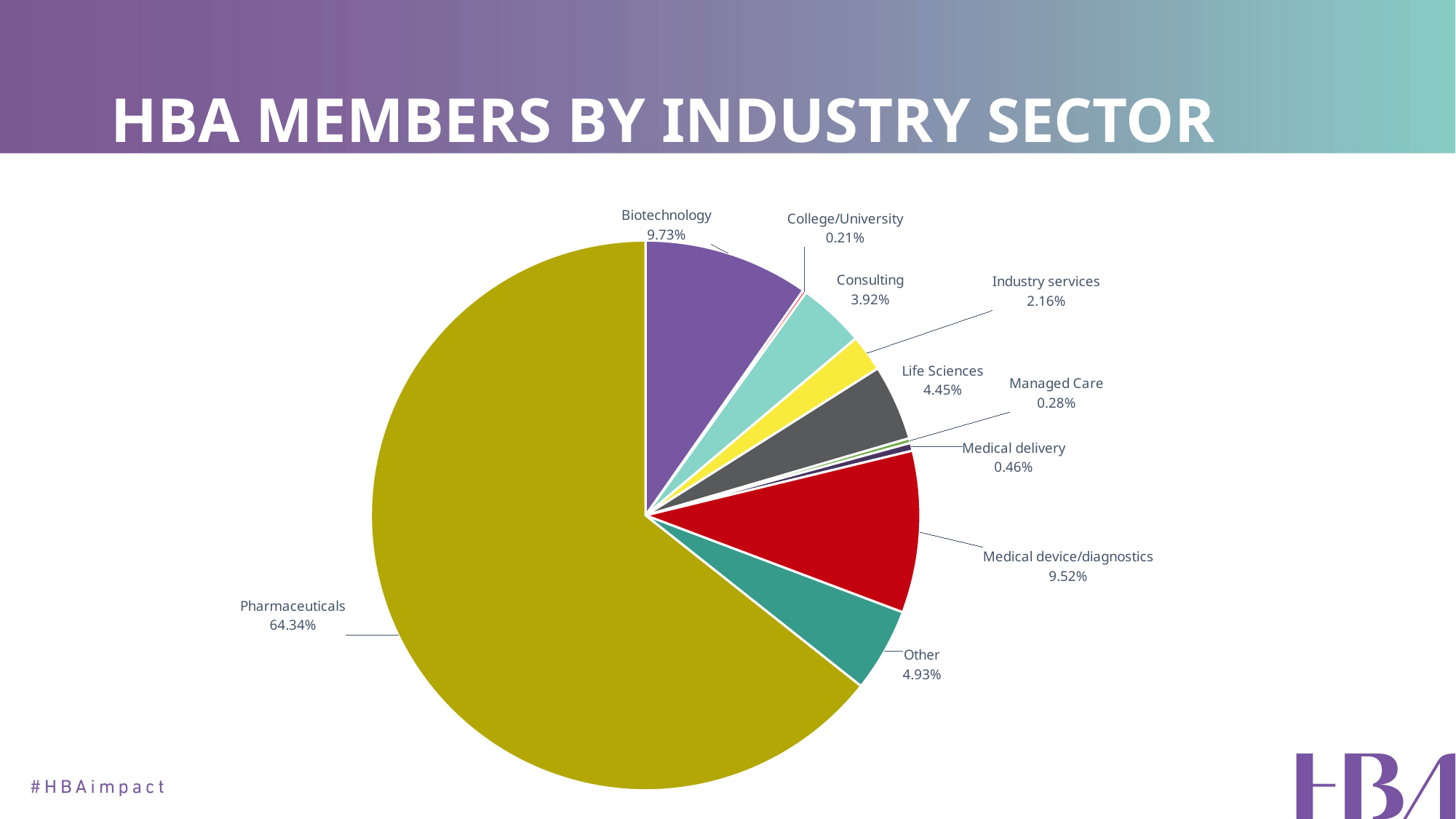
How many percentage points larger is the Pharmaceuticals share than the Biotechnology share? 54.61 How many industry sectors are shown in the pie chart? 10 What is the title of the chart on the slide? HBA Members by Industry Sector What is the difference in percentage points between Consulting and Industry services? 1.76 Which industry sector has the largest share of HBA members? Pharmaceuticals Which industry sector has the smallest share of HBA members? College/University What percentage of HBA members are in Biotechnology? 9.73% What is the value shown for Medical device/diagnostics? 9.52% What type of chart is shown on the slide? Pie chart What percentage is shown for Consulting? 3.92% What share of HBA members are in the Pharmaceuticals sector? 64.34% Which is larger, the share for Other or the share for Life Sciences? Other